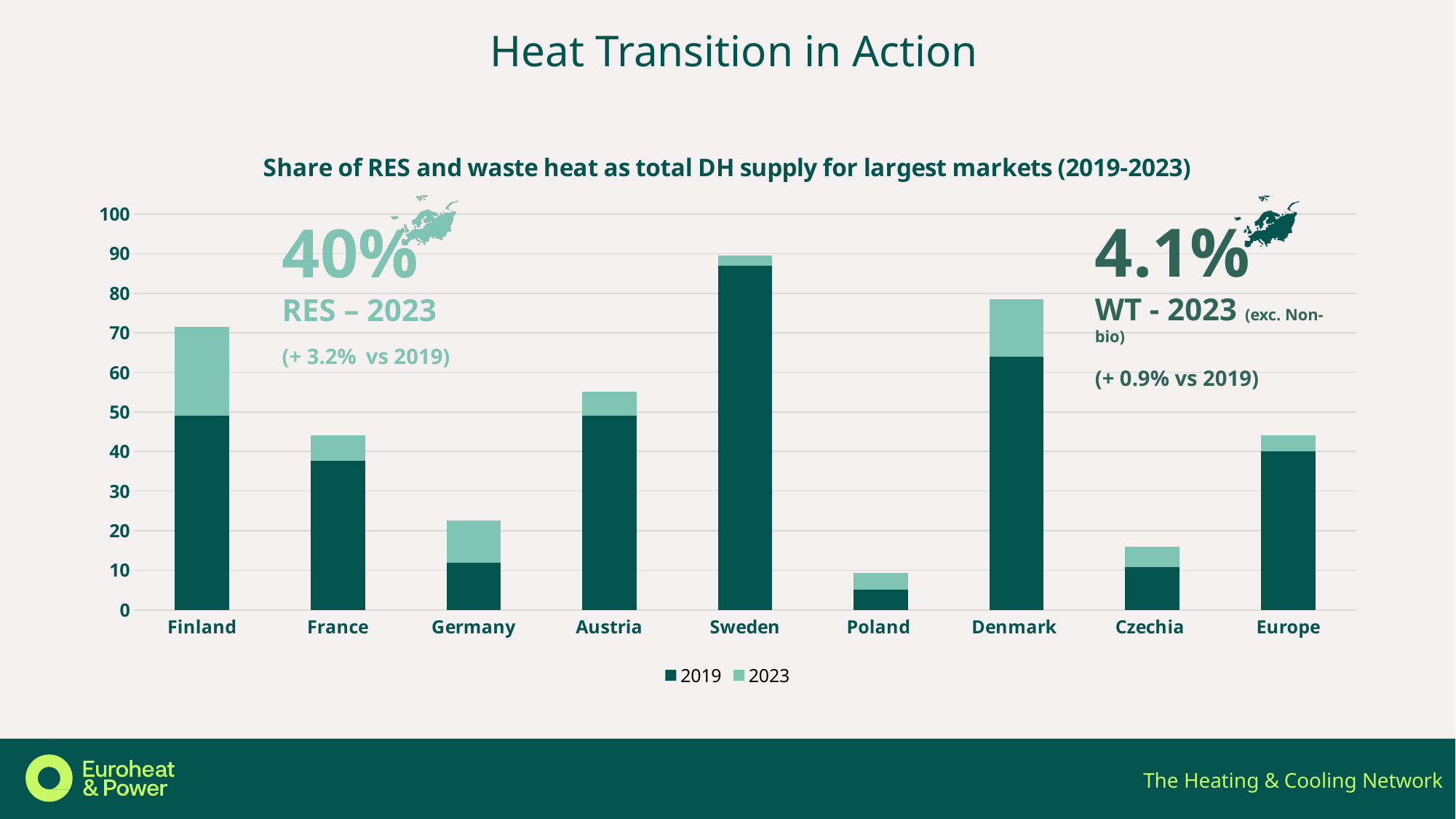
Is the 2019 value for Denmark greater or less than 60? greater How many series does the chart legend list? 2 Is the 2019 value for Sweden greater or less than 80? greater Which has a taller bar, Denmark or Finland? Denmark Which category has the highest bar in the chart? Sweden Which has a taller bar, Germany or Czechia? Germany Is the top of the Czechia bar greater or less than 20? less Which category has the lowest bar in the chart? Poland What kind of chart is shown on the slide? bar chart What is the title of the chart? Share of RES and waste heat as total DH supply for largest markets (2019-2023) How many countries or regions are shown on the x axis of the chart? 9